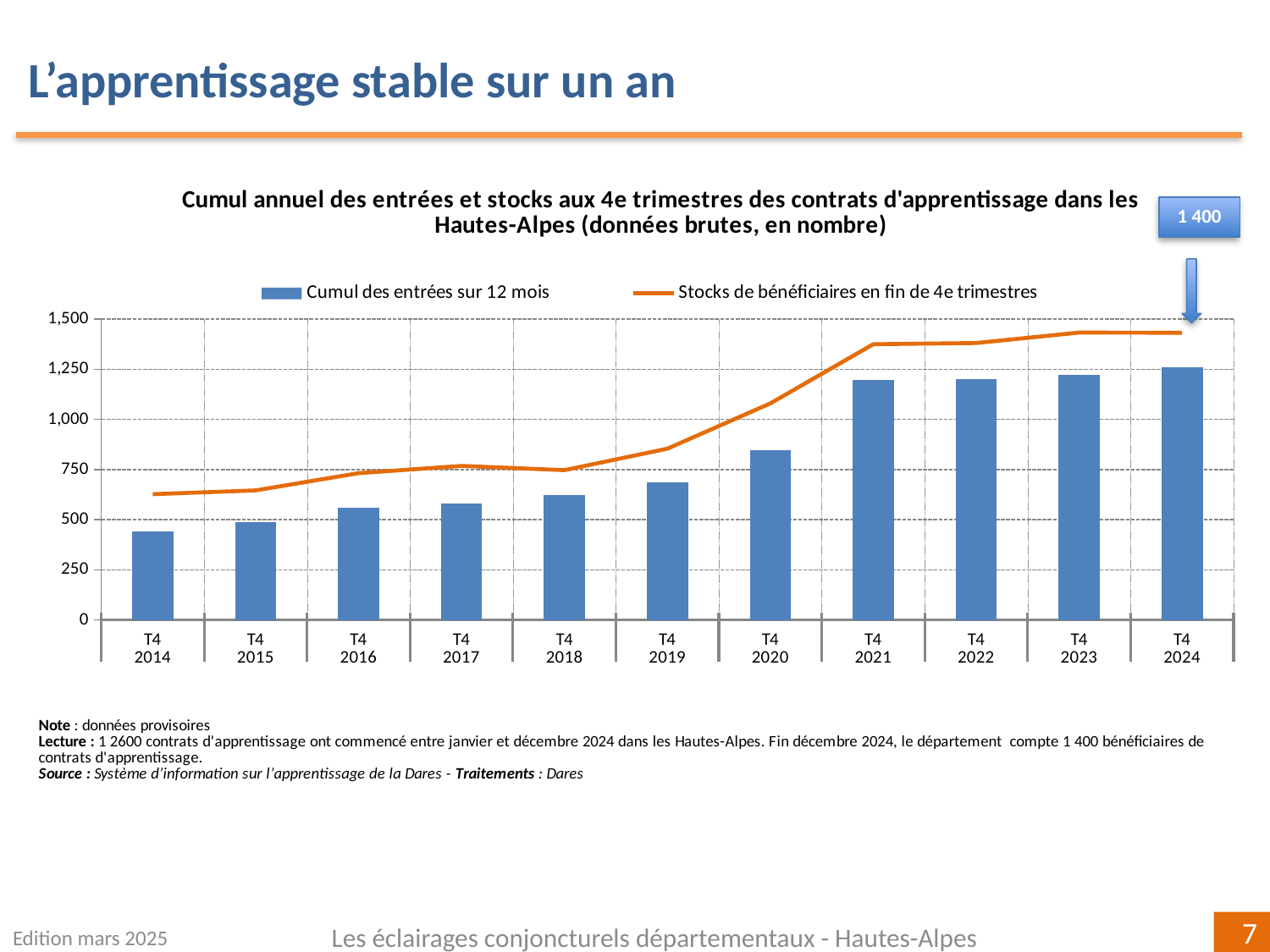
Is the 'Cumul des entrées sur 12 mois' bar for T4 2020 greater or less than 750? greater Is the 'Cumul des entrées sur 12 mois' bar for T4 2014 greater or less than 500? less Which series is drawn as an orange line? Stocks de bénéficiaires en fin de 4e trimestres How many quarters (categories) are shown on the x axis? 11 What is the value of 'Stocks de bénéficiaires en fin de 4e trimestres' at T4 2024? 1 400 Is the 'Stocks de bénéficiaires en fin de 4e trimestres' value at T4 2021 greater or less than 1,250? greater What type of chart is shown on the slide? Combined bar and line chart How many series does the legend list? 2 Do the 'Cumul des entrées sur 12 mois' bars generally rise or fall from T4 2014 to T4 2024? rise Which quarter has the lowest bar for 'Cumul des entrées sur 12 mois'? T4 2014 Which is larger at T4 2020: the 'Cumul des entrées sur 12 mois' bar or the 'Cumul des entrées sur 12 mois' bar at T4 2019? T4 2020 Which quarter has the highest bar for 'Cumul des entrées sur 12 mois'? T4 2024